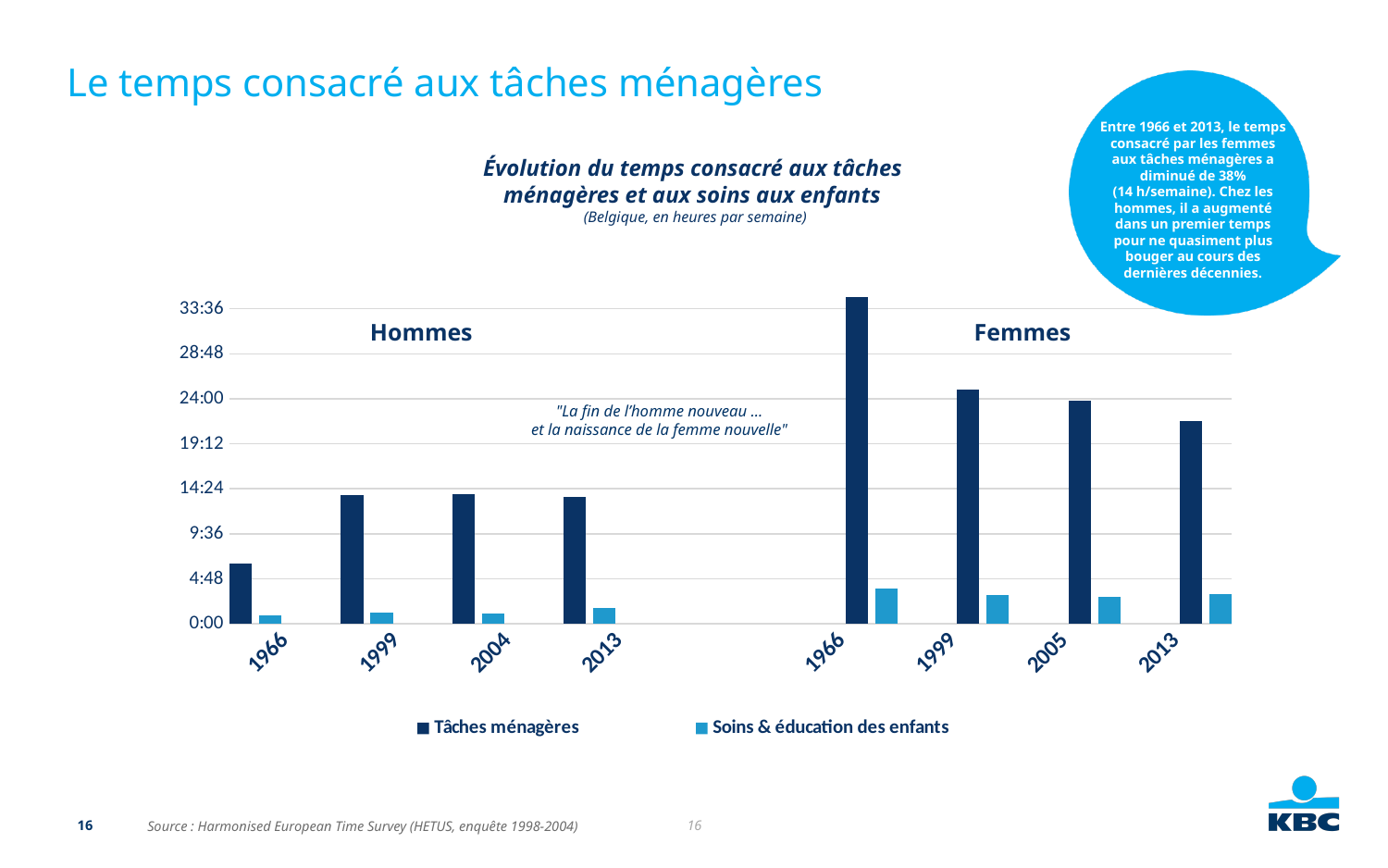
Is the Tâches ménagères value for Hommes in 1966 greater or less than 4:48? greater Which group and year has the highest Tâches ménagères bar? Femmes 1966 Among the Hommes years, which has the lowest Tâches ménagères bar? 1966 How many year categories are shown on the x axis in total (Hommes and Femmes combined)? 8 How many series does the legend list? 2 Which is larger in 2013: the Tâches ménagères bar for Hommes or for Femmes? Femmes Do the Tâches ménagères values for Femmes rise or fall from 1966 to 2013? fall What are the two series named in the legend? Tâches ménagères; Soins & éducation des enfants What kind of chart is shown on the slide? bar chart Is the Tâches ménagères value for Femmes in 1966 greater or less than 28:48? greater What is the title of the chart? Évolution du temps consacré aux tâches ménagères et aux soins aux enfants Is the Tâches ménagères value for Femmes in 2013 greater or less than 24:00? less